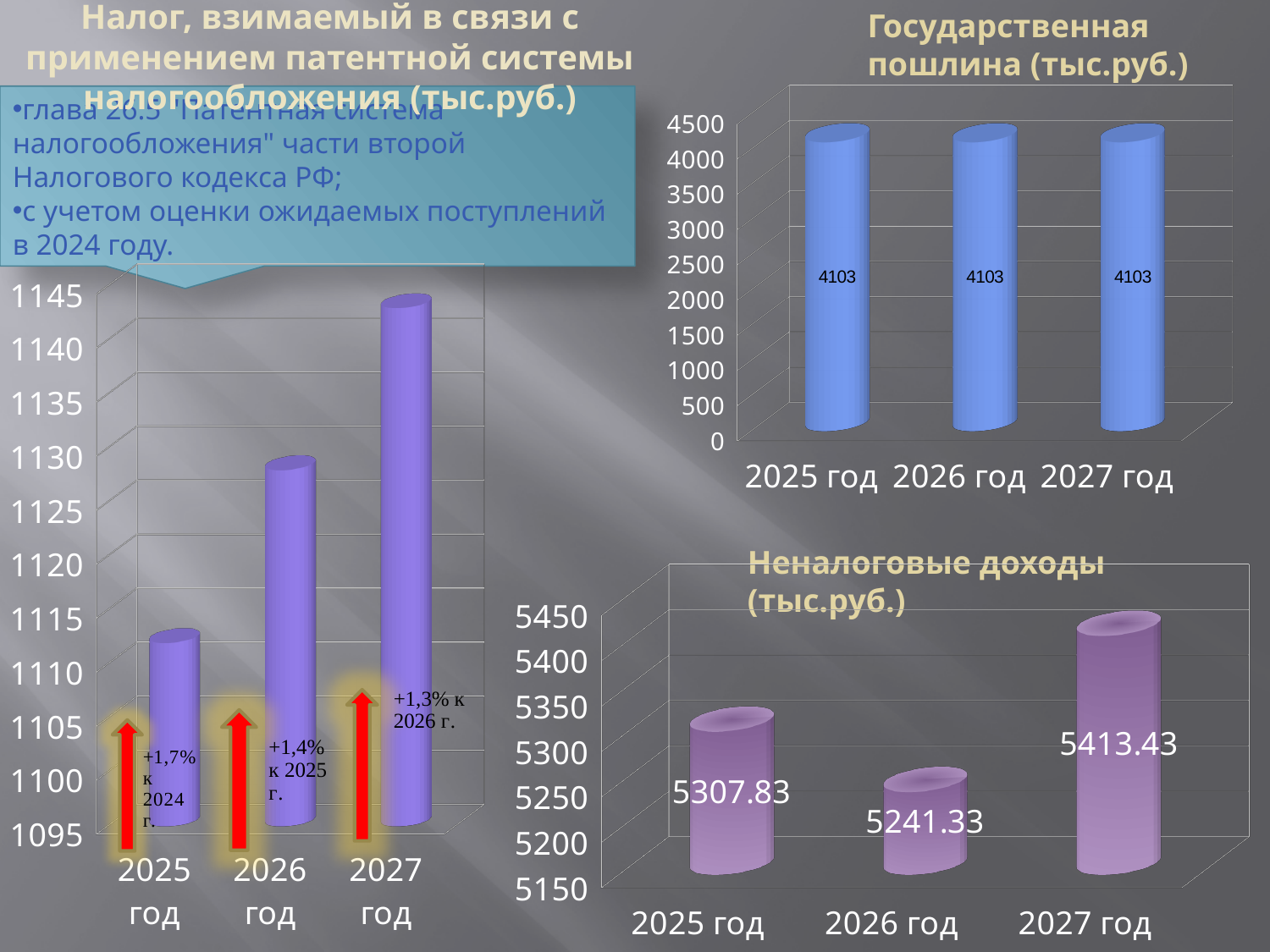
In the chart titled "Неналоговые доходы (тыс.руб.)", which is larger, the value for 2025 год or 2026 год? 2025 год In the chart titled "Налог, взимаемый в связи с применением патентной системы налогообложения (тыс.руб.)", is the value for 2025 год greater or less than 1115? less How many bars are shown in the chart titled "Государственная пошлина (тыс.руб.)"? 3 In the chart titled "Неналоговые доходы (тыс.руб.)", what is the difference between the values for 2027 год and 2025 год? 105.60 In the chart titled "Государственная пошлина (тыс.руб.)", what is the value for 2025 год? 4103 In the chart titled "Неналоговые доходы (тыс.руб.)", which year has the highest value? 2027 год What kind of chart is the chart titled "Неналоговые доходы (тыс.руб.)"? bar chart In the chart titled "Налог, взимаемый в связи с применением патентной системы налогообложения (тыс.руб.)", is the value for 2027 год greater or less than 1140? greater In the chart titled "Неналоговые доходы (тыс.руб.)", what is the value for 2026 год? 5241.33 In the chart titled "Неналоговые доходы (тыс.руб.)", which year has the lowest value? 2026 год In the chart titled "Неналоговые доходы (тыс.руб.)", what is the value for 2027 год? 5413.43 In the chart titled "Налог, взимаемый в связи с применением патентной системы налогообложения (тыс.руб.)", do the values rise or fall from 2025 год to 2027 год? rise